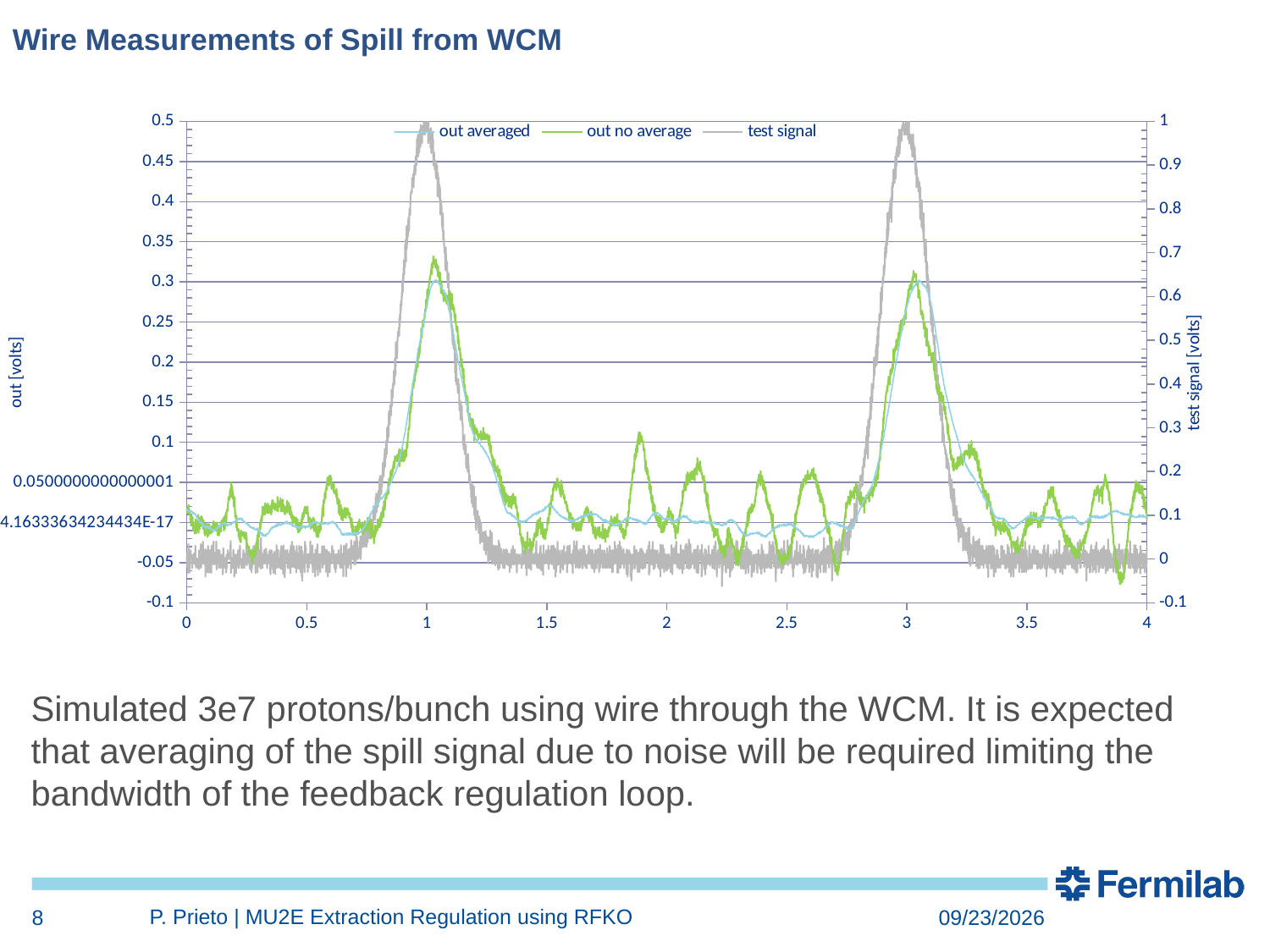
How many large peaks does the test signal series show across the chart? 2 What is the highest tick value shown on the left vertical axis? 0.5 What is the highest tick value shown on the right vertical axis (test signal)? 1 How many series does the chart legend list? 3 What is the title of the left vertical axis of the chart? out [volts] Is the peak of the test signal near x=1 greater or less than 0.9 on the right axis? greater What are the three series named in the chart legend? out averaged, out no average, test signal Is the test signal value at x=2 greater or less than 0.5 on the right axis? less What kind of chart is shown on the slide? line chart What is the largest value shown on the horizontal axis? 4 Near x=1, which series reaches a higher peak on the left axis: out no average or out averaged? out no average Is the peak of the out no average series near x=1 greater or less than 0.3 on the left axis? greater